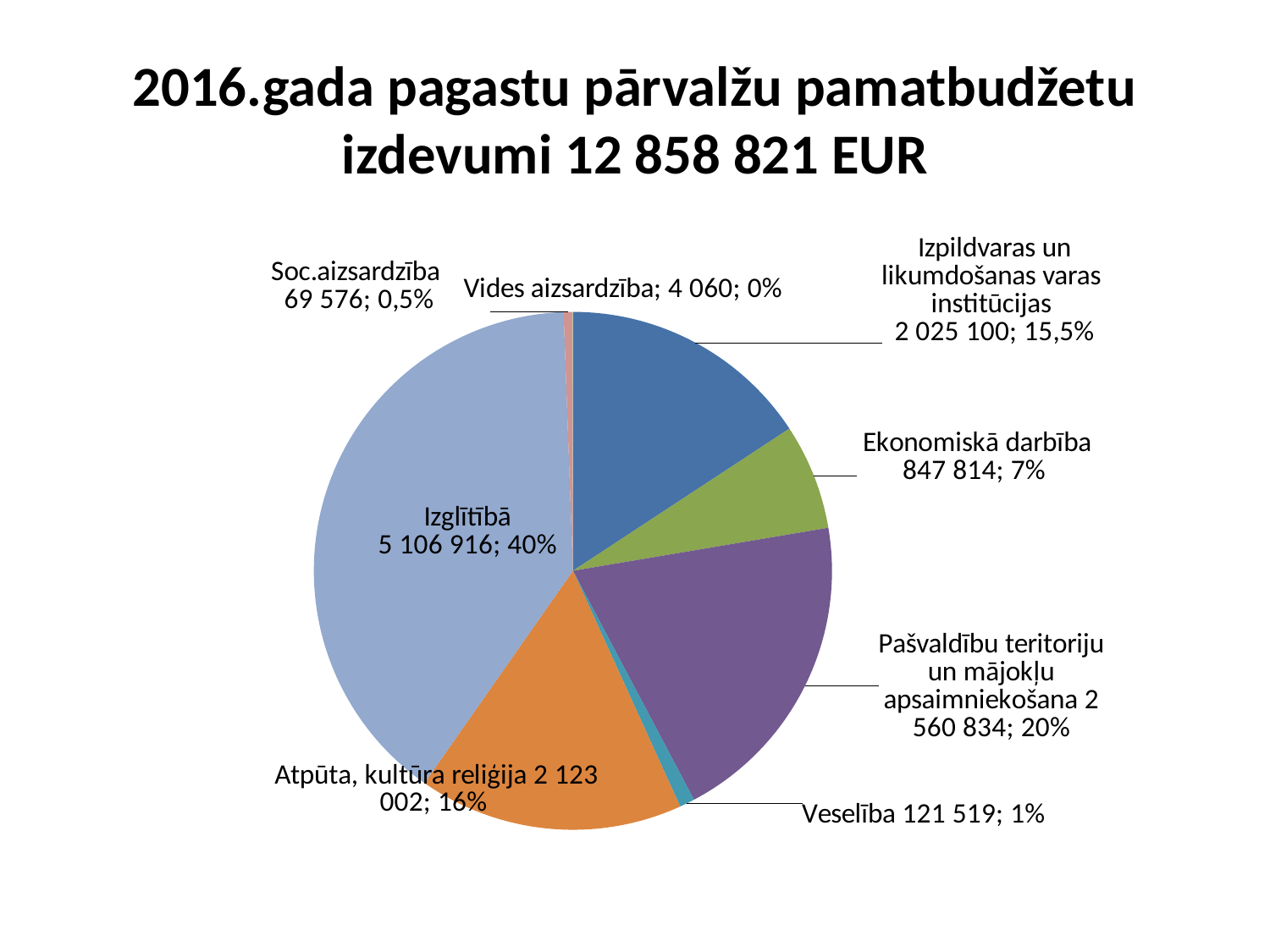
What is the value shown for Izglītībā? 5 106 916 Which category has the smallest slice of the pie? Vides aizsardzība What is the value shown for Ekonomiskā darbība? 847 814 What is the value shown for Vides aizsardzība? 4 060 What is the difference between the values for Pašvaldību teritoriju un mājokļu apsaimniekošana and Atpūta, kultūra reliģija? 437 832 What percentage share is shown for Izpildvaras un likumdošanas varas institūcijas? 15,5% What kind of chart is shown on the slide? Pie chart What total amount in EUR is stated in the slide title? 12 858 821 EUR What percentage share is shown for Pašvaldību teritoriju un mājokļu apsaimniekošana? 20% How many categories are shown in the pie chart? 8 Which is larger, the value for Veselība or the value for Soc.aizsardzība? Veselība Which category has the largest slice of the pie? Izglītībā